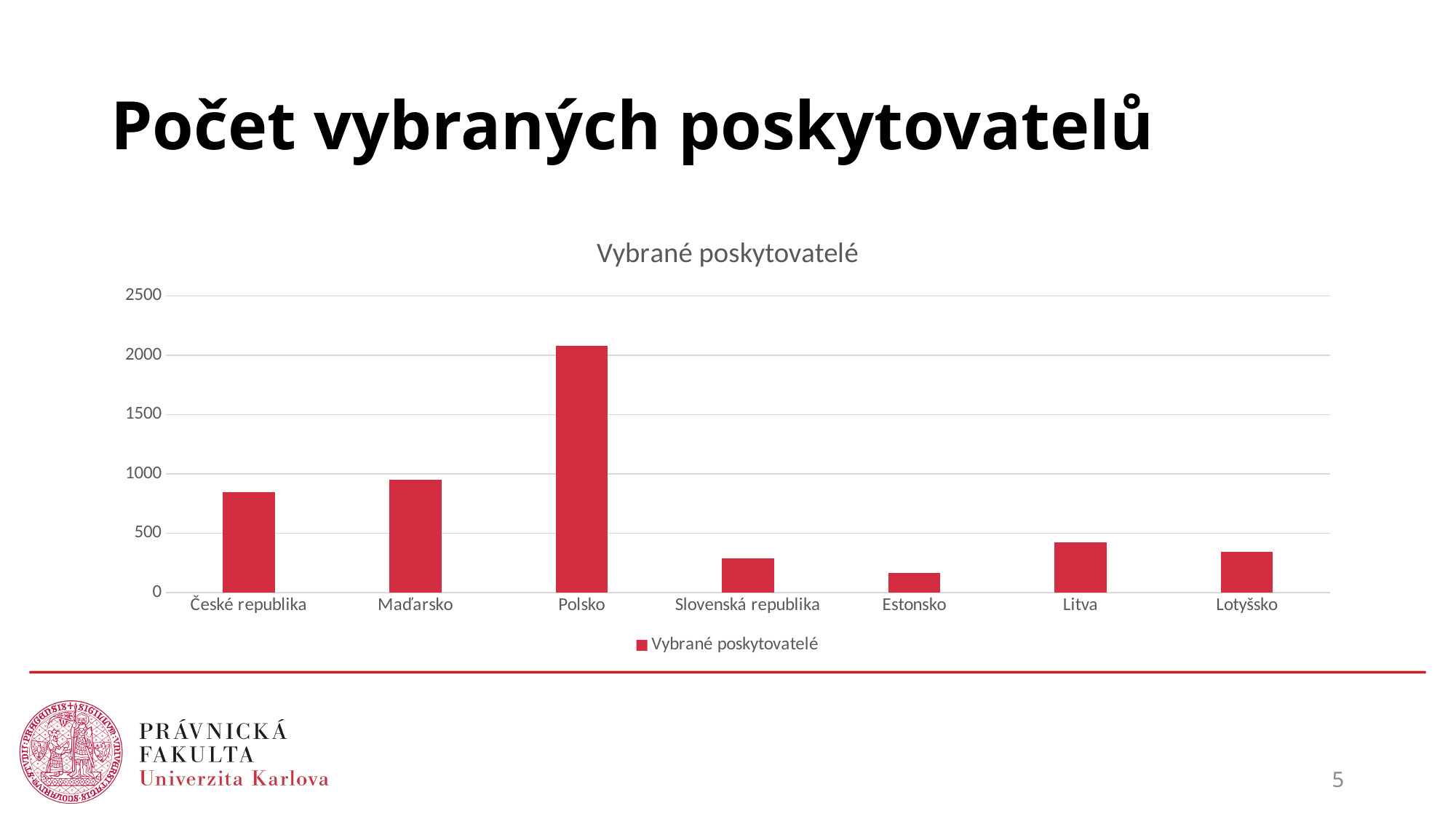
How many series does the chart legend list? 1 Is the value for Polsko greater or less than 2000? greater Is the value for Slovenská republika greater or less than 500? less Which country has the highest value in the chart? Polsko Which country has the lowest value in the chart? Estonsko Which has a larger value, Maďarsko or České republika? Maďarsko Is the value for Litva greater or less than 500? less What is the title of the chart? Vybrané poskytovatelé How many countries are shown on the x axis of the chart? 7 Which has a larger value, Litva or Lotyšsko? Litva What kind of chart is shown on the slide? Bar chart